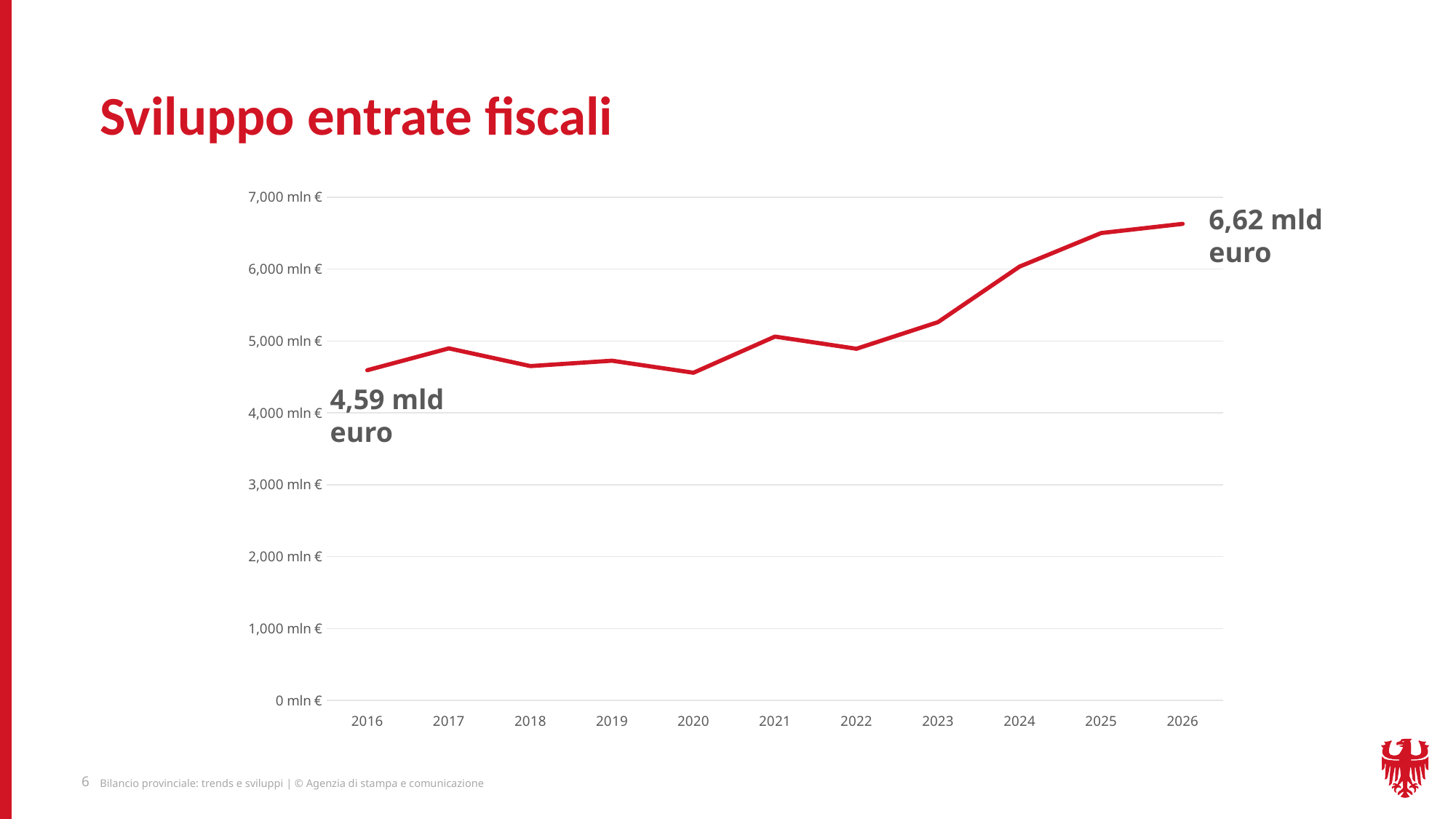
Which year has the highest value? 2026 Do the values generally rise or fall from 2016 to 2026? rise What kind of chart is shown on the slide? line chart What is the value shown for 2026? 6,62 mld euro How many years are plotted on the x axis? 11 Is the value for 2018 greater or less than 5,000 mln €? less What is the title of the chart? Sviluppo entrate fiscali What is the difference between the 2026 value and the 2016 value? 2,03 mld euro What is the value shown for 2016? 4,59 mld euro Is the value for 2023 greater or less than 6,000 mln €? less Is the value for 2025 greater or less than 6,000 mln €? greater Which year has the larger value, 2020 or 2025? 2025